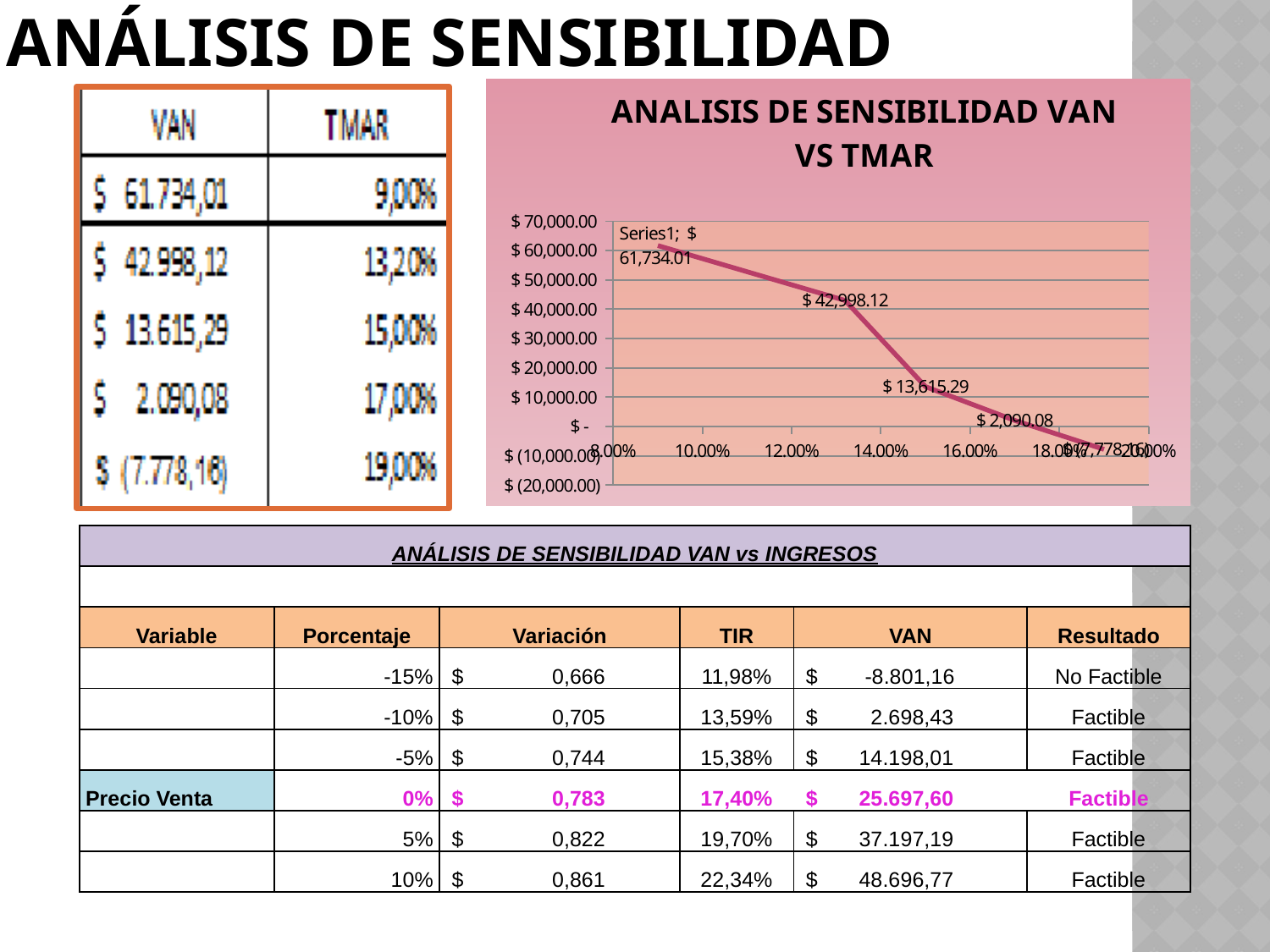
Which data point on the chart has the highest VAN value? The first (leftmost) point, $ 61,734.01 How many data points are plotted on the line in the chart? 5 What is the title of the chart? ANALISIS DE SENSIBILIDAD VAN VS TMAR What is the value of the fourth data point from the left on the chart? $ 2,090.08 Which is larger: the second data point or the third data point on the chart? The second data point ($ 42,998.12) What is the difference between the first data point ($ 61,734.01) and the second data point ($ 42,998.12)? $ 18,735.89 Does the VAN value rise or fall as TMAR increases along the x axis? Fall What is the value of the first (leftmost) data point on the chart? $ 61,734.01 What is the value of the third data point from the left on the chart? $ 13,615.29 Is the value of the fourth data point on the chart greater or less than $ 10,000.00? less What is the value of the second data point from the left on the chart? $ 42,998.12 What type of chart is shown on the slide? Line chart